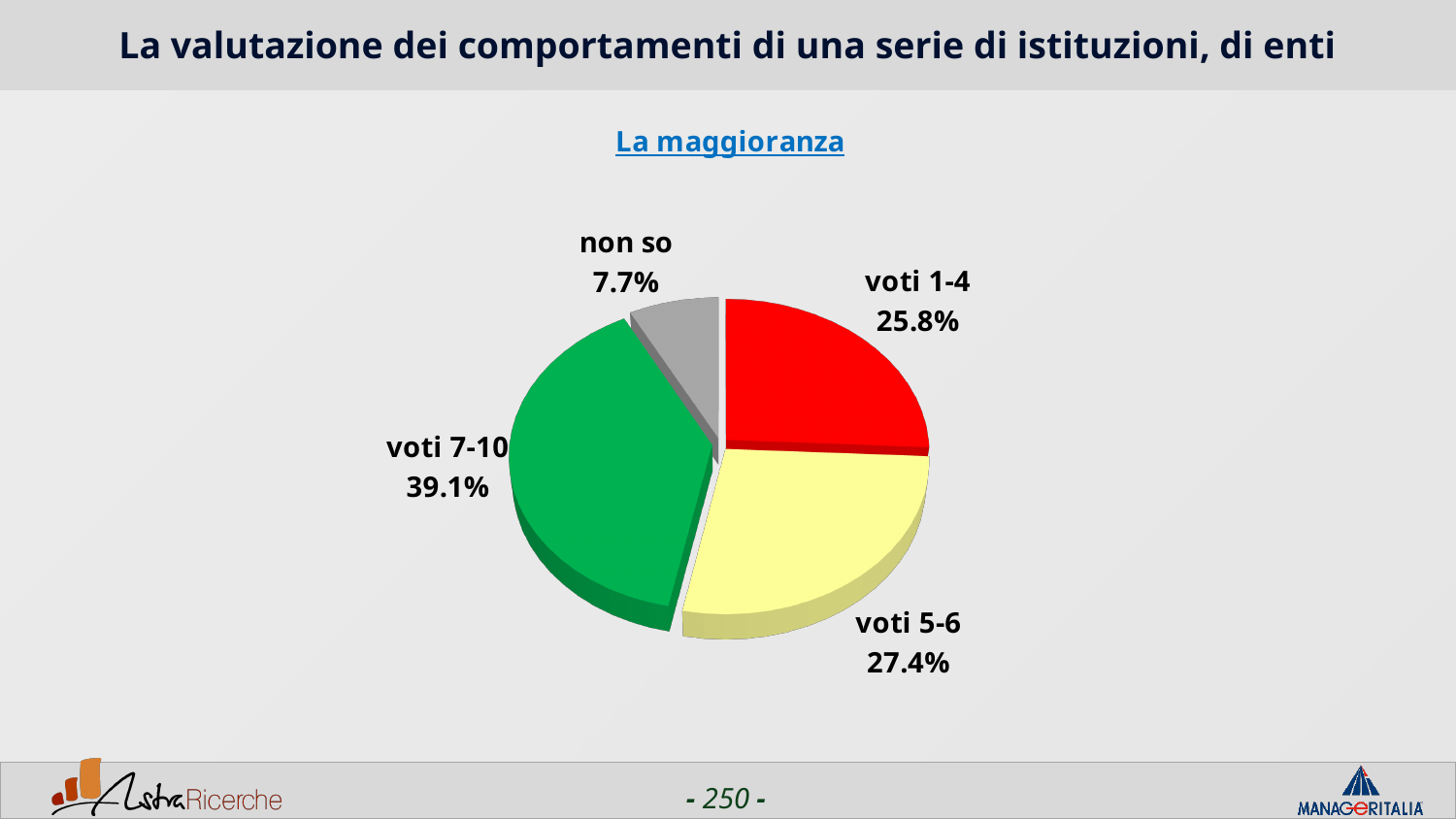
What is the share for 'voti 1-4'? 25.8% What kind of chart is shown on the slide? pie chart What colour is the slice for 'voti 7-10'? green How many slices does the pie chart have? 4 What is the share for 'voti 5-6'? 27.4% What is the share for 'voti 7-10'? 39.1% Which is larger, the share for 'voti 5-6' or the share for 'voti 1-4'? voti 5-6 What is the share for 'non so'? 7.7% Which category has the largest slice? voti 7-10 What is the title of the chart? La maggioranza What is the difference between the shares for 'voti 7-10' and 'voti 1-4'? 13.3% Which category has the smallest slice? non so